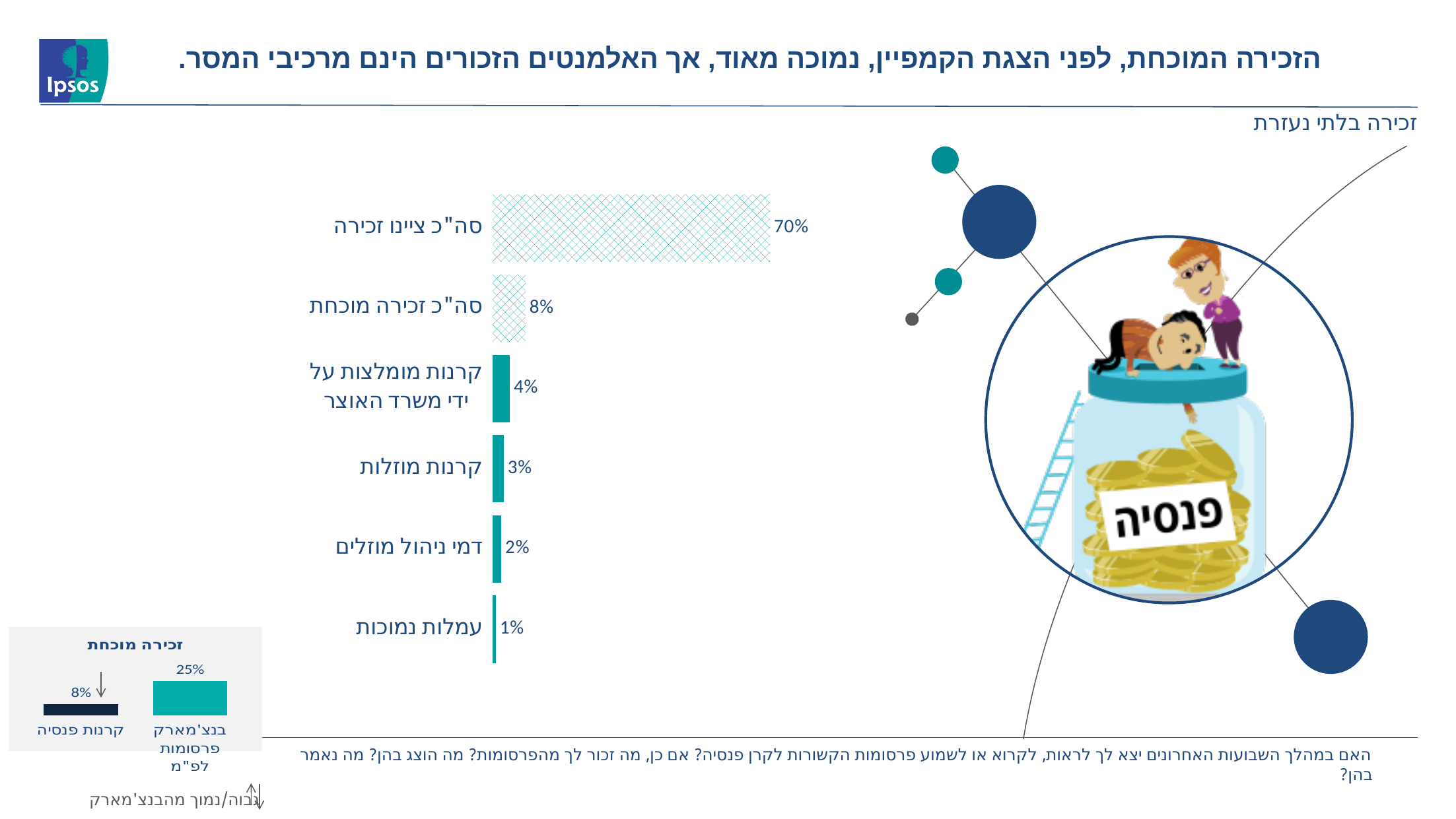
In the main bar chart, what is the value for עמלות נמוכות? 1% In the main bar chart, what is the value for סה"כ זכירה מוכחת? 8% In the main bar chart, which category has the lowest value? עמלות נמוכות What type of chart is the main chart on the slide? bar chart In the small inset chart titled זכירה מוכחת at the bottom left, what is the difference between בנצ'מארק פרסומות לפ"מ and קרנות פנסיה? 17% In the main bar chart, what is the value for קרנות מומלצות על ידי משרד האוצר? 4% In the main bar chart, which category has the highest value? סה"כ ציינו זכירה In the main bar chart, which is larger: קרנות מוזלות or דמי ניהול מוזלים? קרנות מוזלות How many categories does the main bar chart show? 6 In the small inset chart titled זכירה מוכחת at the bottom left, what is the value for בנצ'מארק פרסומות לפ"מ? 25% In the main bar chart, what is the difference between סה"כ ציינו זכירה and סה"כ זכירה מוכחת? 62% In the main bar chart, what is the value for סה"כ ציינו זכירה? 70%